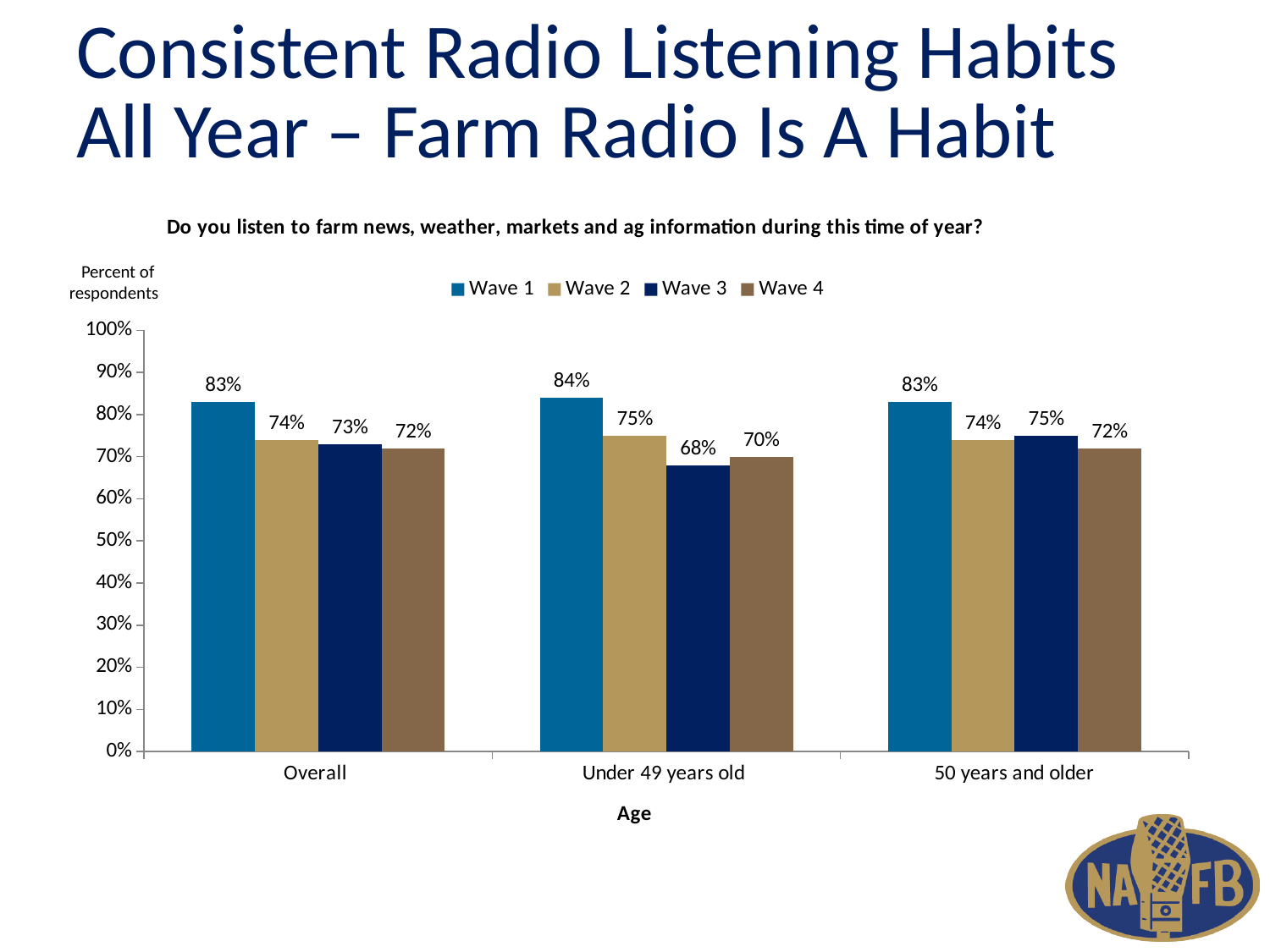
What is the Wave 3 value for Under 49 years old? 68% How many age categories are shown on the x axis? 3 What is the label on the x axis of the chart? Age Which wave has the highest value for Under 49 years old? Wave 1 What is the difference between the Wave 1 and Wave 3 values for Under 49 years old? 16% Which is larger for 50 years and older: Wave 2 or Wave 3? Wave 3 What is the Wave 4 value for 50 years and older? 72% How many series does the legend list? 4 What kind of chart is shown on the slide? Bar chart Which wave has the lowest value for Under 49 years old? Wave 3 What is the Wave 1 value for Overall? 83% What is the Wave 2 value for Under 49 years old? 75%